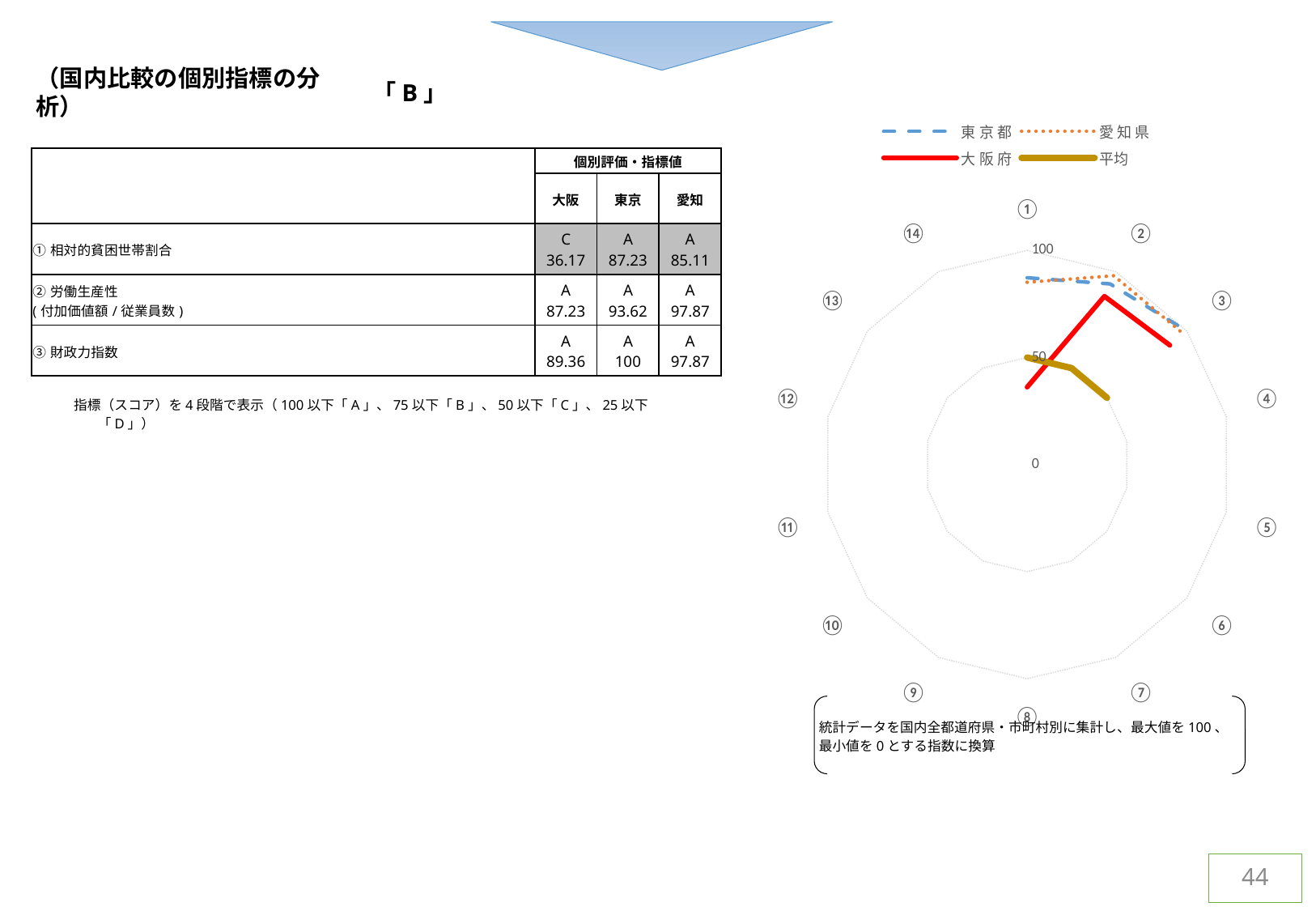
In the radar chart, which is larger at category ②: 大阪府 or 平均? 大阪府 In the radar chart, is the value for 大阪府 at category ② greater or less than 50? greater What kind of chart is shown on the right of the slide? radar chart How many numbered categories are arranged around the radar chart? 14 In the radar chart, which series has the lowest value at category ①? 大阪府 Which series in the radar chart is drawn as a solid red line? 大阪府 Which series in the radar chart is drawn as a dotted orange line? 愛知県 In the radar chart, is the value for 愛知県 at category ③ greater or less than 50? greater In the radar chart, is the value for 東京都 at category ① greater or less than 50? greater In the radar chart, which is larger at category ①: 大阪府 or 東京都? 東京都 How many series does the legend of the radar chart list? 4